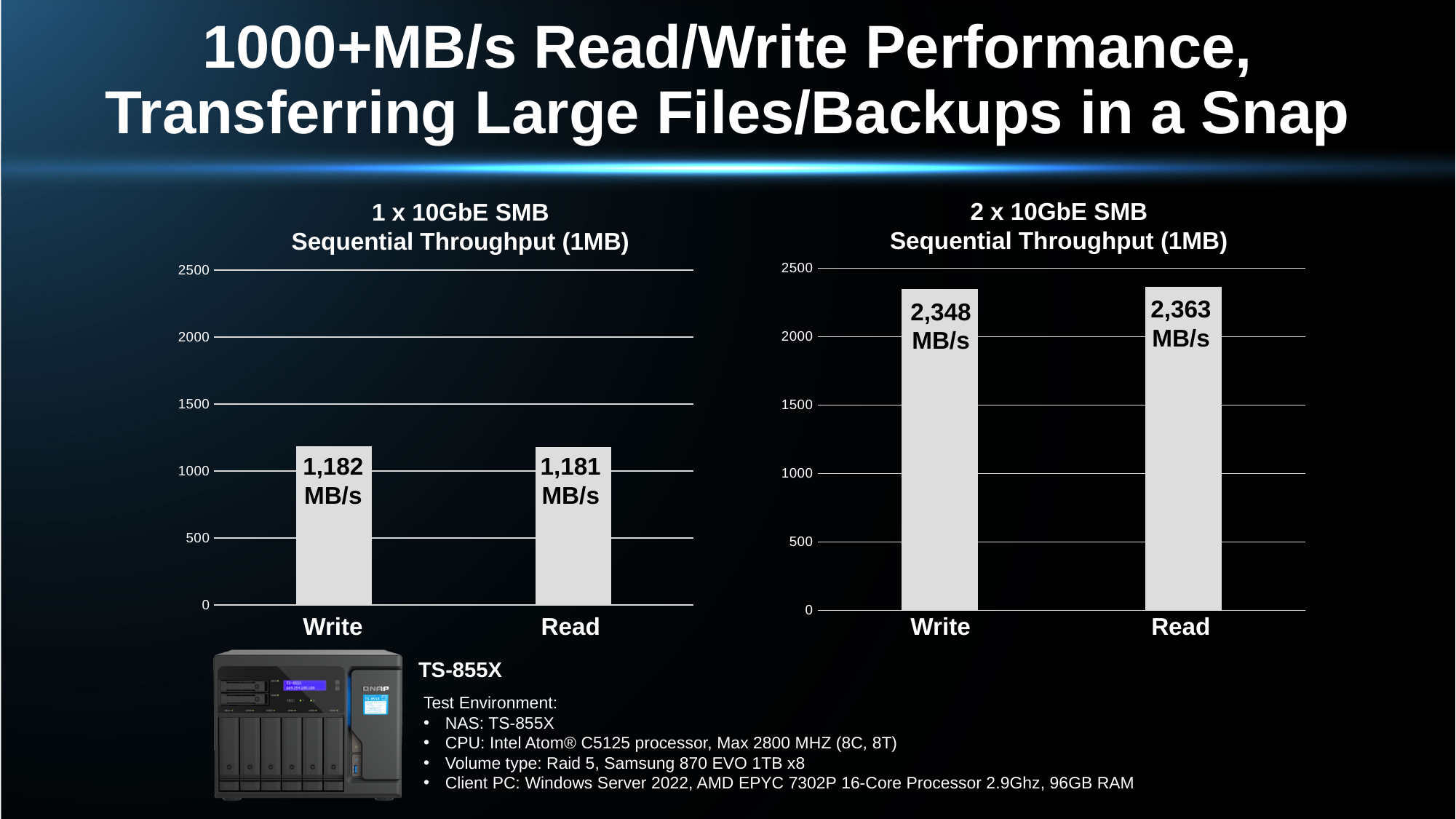
In the 1 x 10GbE SMB Sequential Throughput (1MB) chart, what is the value for Write? 1,182 MB/s What kind of chart is the 2 x 10GbE SMB Sequential Throughput (1MB) chart? Bar chart What is the highest value shown on the vertical axis of the 1 x 10GbE SMB Sequential Throughput (1MB) chart? 2500 In the 2 x 10GbE SMB Sequential Throughput (1MB) chart, what is the value for Write? 2,348 MB/s In the 1 x 10GbE SMB Sequential Throughput (1MB) chart, what is the value for Read? 1,181 MB/s In the 2 x 10GbE SMB Sequential Throughput (1MB) chart, what is the value for Read? 2,363 MB/s How many categories are shown in the 1 x 10GbE SMB Sequential Throughput (1MB) chart? 2 What is the title of the chart on the right side of the slide? 2 x 10GbE SMB Sequential Throughput (1MB) In the 1 x 10GbE SMB Sequential Throughput (1MB) chart, is the value for Write greater or less than 1000? greater In the 2 x 10GbE SMB Sequential Throughput (1MB) chart, what is the difference between the Read and Write values? 15 MB/s In the 2 x 10GbE SMB Sequential Throughput (1MB) chart, is the value for Read greater or less than 2500? less In the 1 x 10GbE SMB Sequential Throughput (1MB) chart, what is the difference between the Write and Read values? 1 MB/s